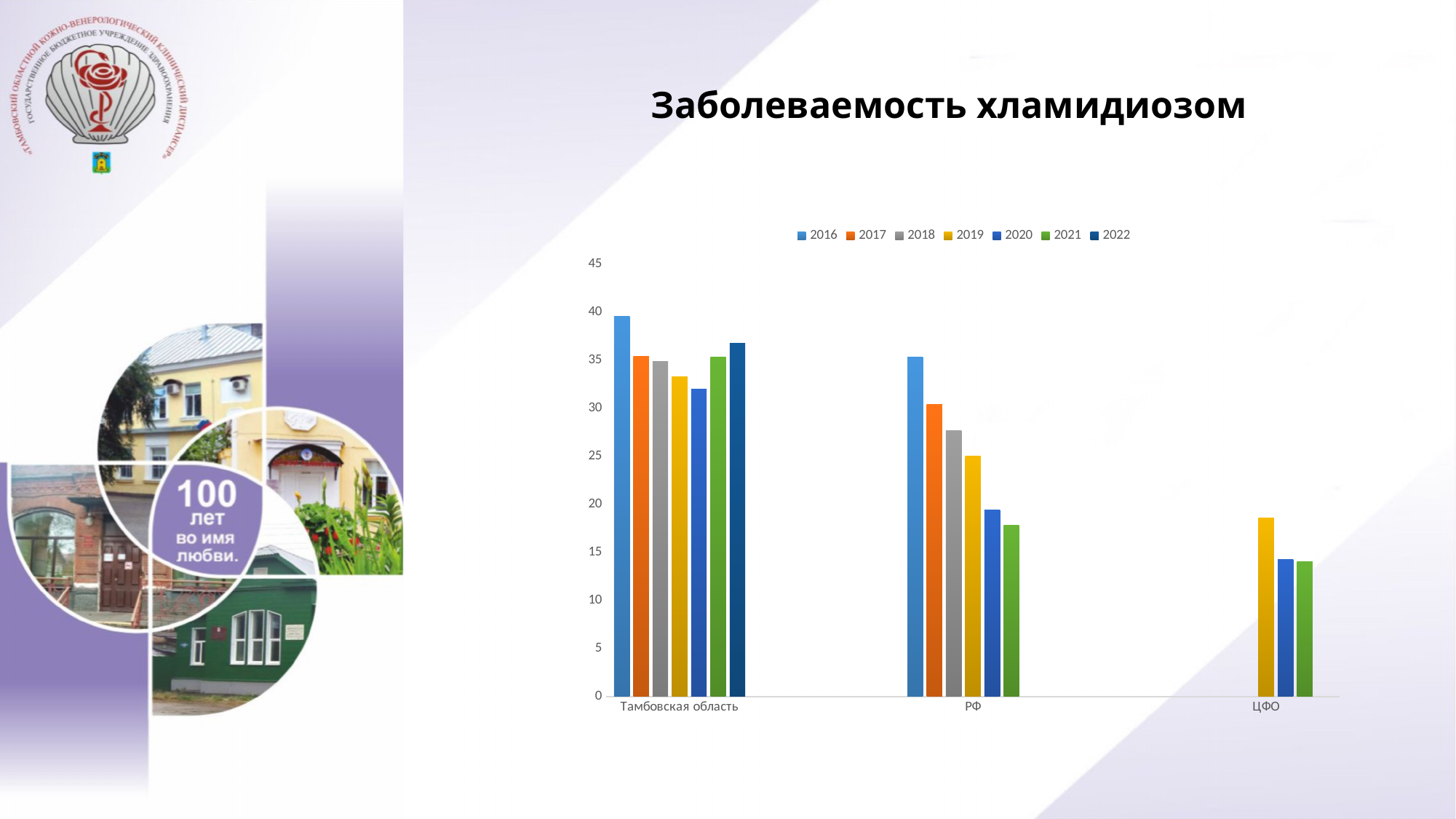
Is the 2016 value for Тамбовская область greater or less than 35? greater For Тамбовская область, which year has the highest bar? 2016 What kind of chart is shown on the slide? bar chart For Тамбовская область, which year has the lowest bar? 2020 What is the title of the chart? Заболеваемость хламидиозом How many categories are shown on the x axis? 3 For РФ, which year has the highest bar? 2016 Is the 2019 value for ЦФО greater or less than 15? greater For РФ, do the values rise or fall from 2016 to 2021? fall Which is larger in 2016: the value for Тамбовская область or the value for РФ? Тамбовская область Is the 2021 value for РФ greater or less than 20? less How many series does the legend list? 7